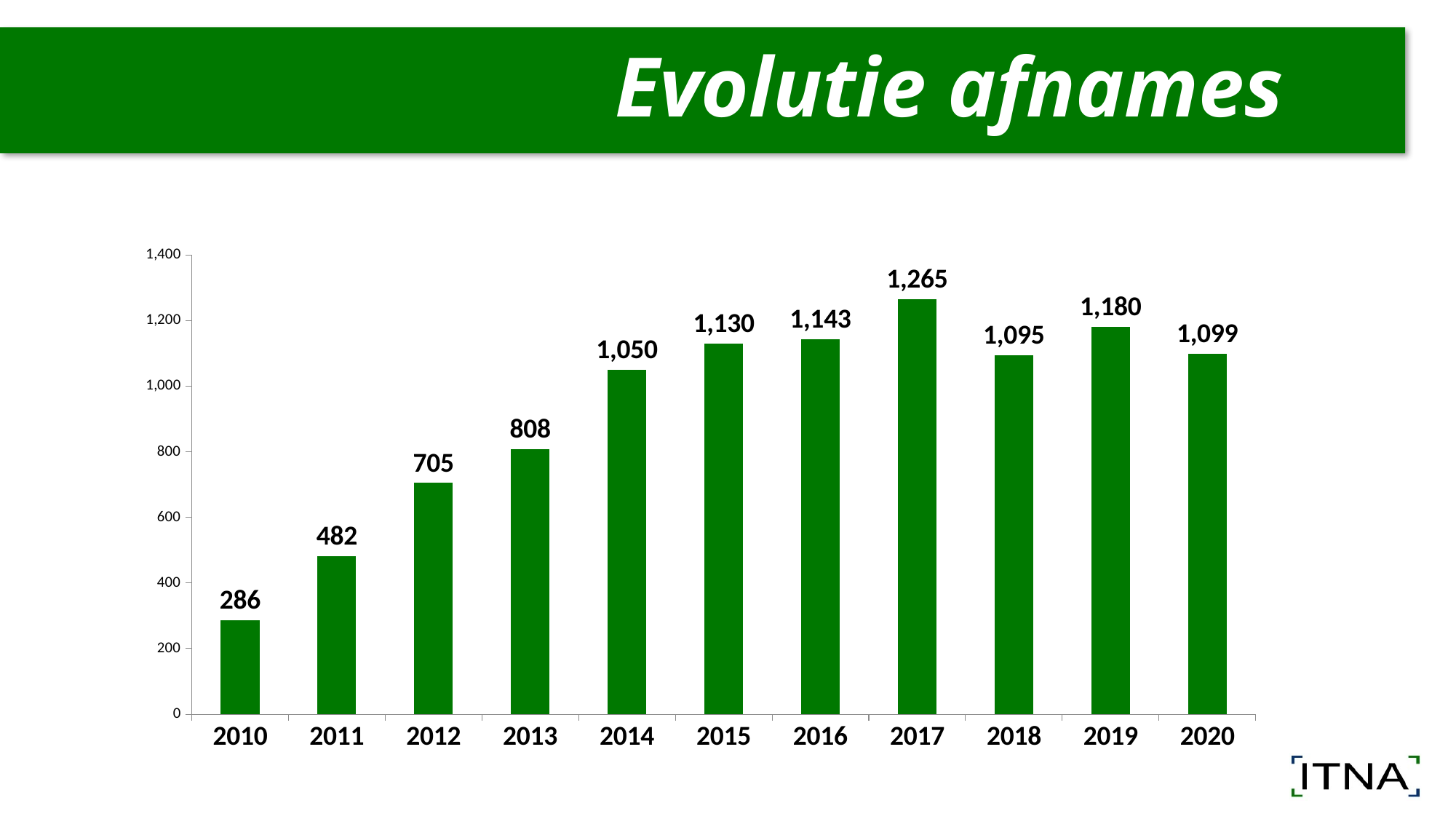
What is the value for 2010? 286 What is the value for 2014? 1,050 Is the value for 2013 greater or less than 1,000? less What is the difference between the values for 2017 and 2018? 170 Which year has the lowest value? 2010 What is the difference between the values for 2012 and 2011? 223 How many years are shown on the x axis? 11 Which year has the highest value? 2017 What kind of chart is shown on the slide? bar chart Which is larger, the value for 2015 or the value for 2020? 2015 What is the value for 2019? 1,180 What is the title of the slide? Evolutie afnames